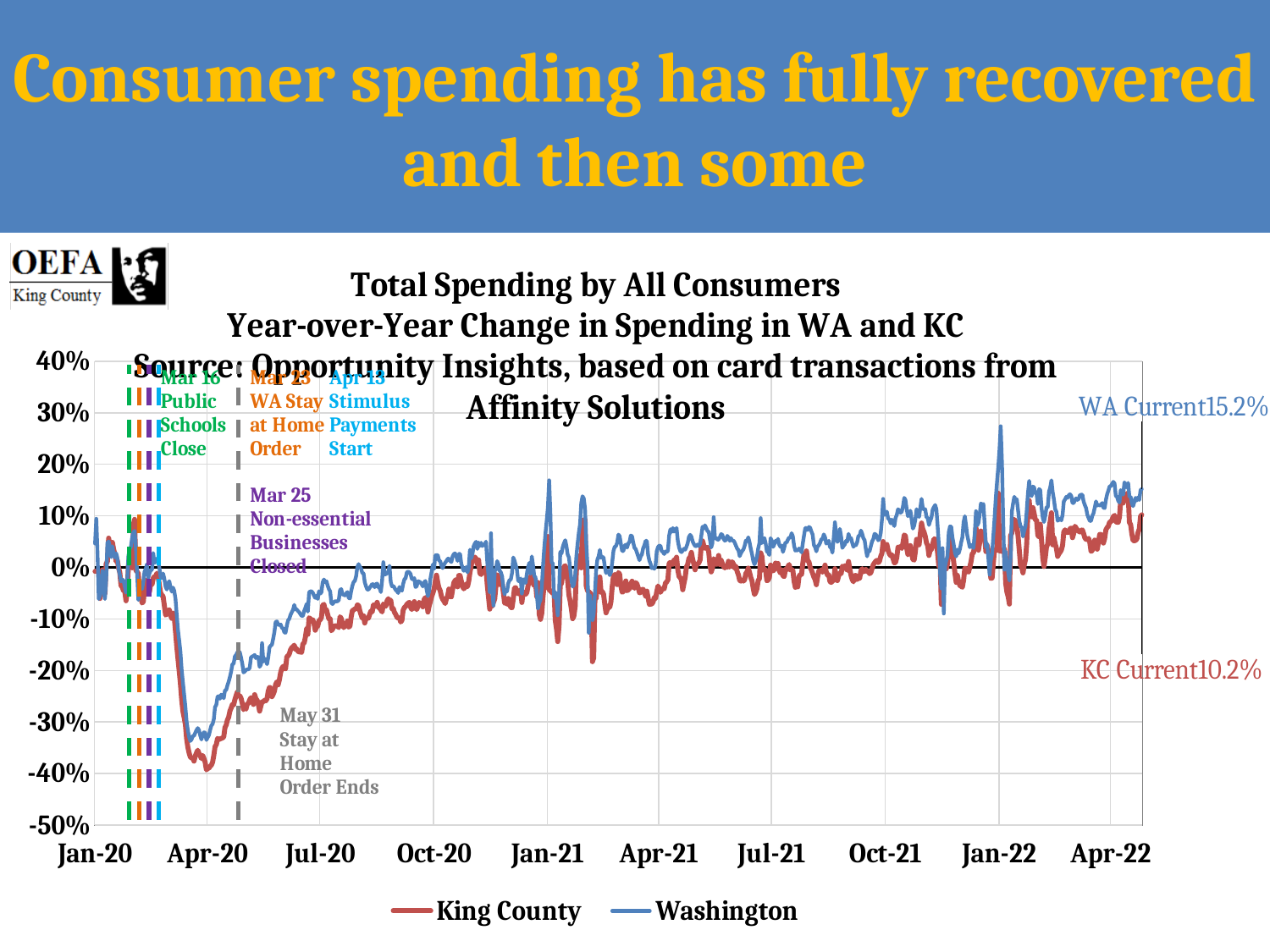
Which is larger, the WA Current value or the KC Current value? WA Current Do the values for both series rise or fall between Apr-20 and Jul-20? rise Is the lowest value for King County around April 2020 greater or less than -30%? less What is the difference between the WA Current and KC Current values? 5.0% What is the current year-over-year change in spending for Washington shown on the chart? 15.2% Which series reached the lower minimum value around April 2020? King County What is the current year-over-year change in spending for King County shown on the chart? 10.2% How many date labels are shown on the x axis? 10 What are the two series named in the legend? King County and Washington How many series does the legend list? 2 Is the lowest value for Washington around April 2020 greater or less than -20%? less What kind of chart is shown on the slide? Line chart